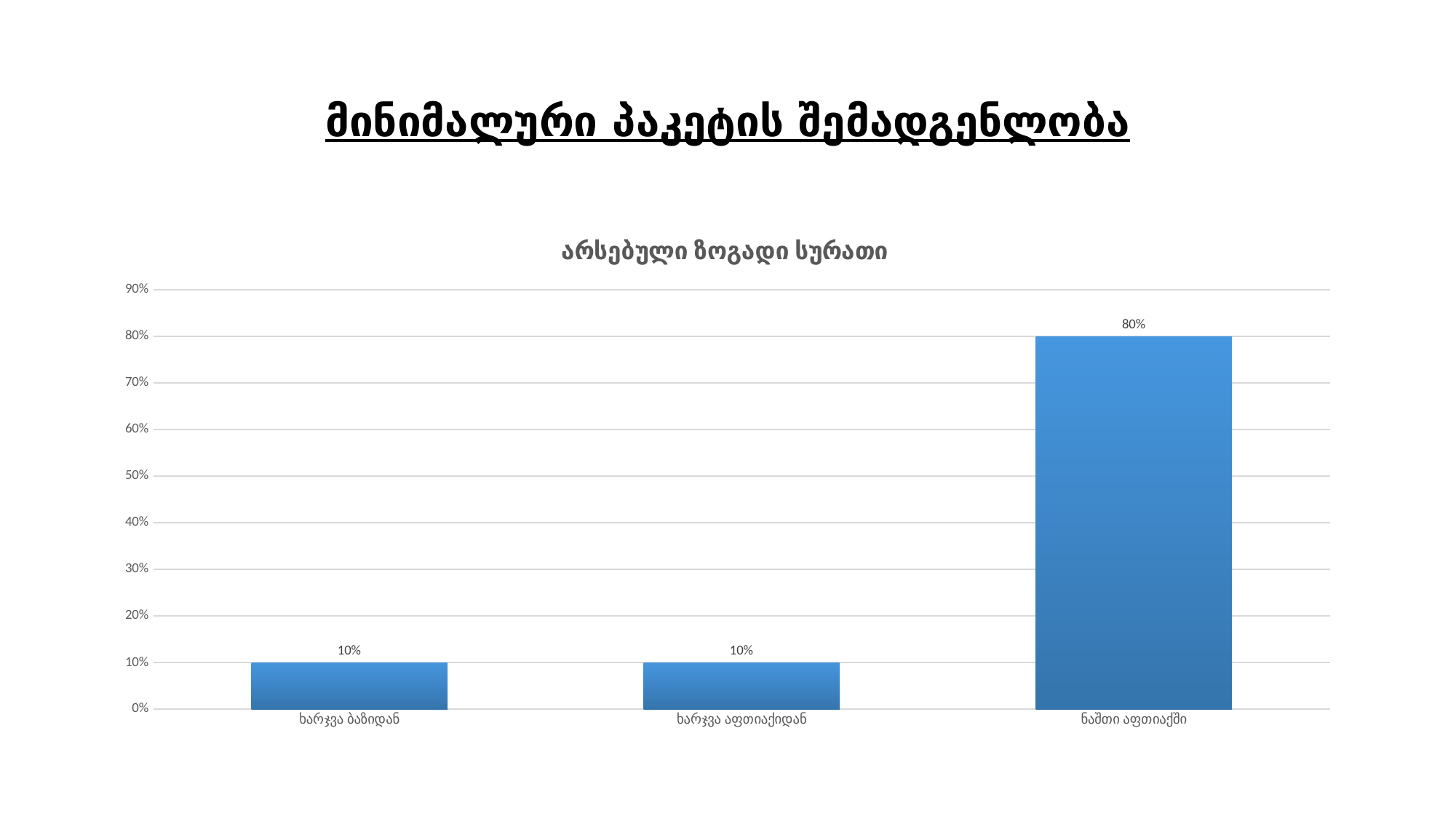
What is the value for ხარჯვა ბაზიდან? 10% What kind of chart is shown on the slide? bar chart What is the value for ხარჯვა აფთიაქიდან? 10% What is the difference between the values for ნაშთი აფთიაქში and ხარჯვა ბაზიდან? 70% What is the highest value shown on the vertical axis? 90% Is the value for ნაშთი აფთიაქში greater or less than 50%? greater How many categories are shown on the chart? 3 Is the value for ხარჯვა ბაზიდან greater or less than 20%? less Which category has the highest value? ნაშთი აფთიაქში What is the title of the chart? არსებული ზოგადი სურათი Which is larger, the value for ნაშთი აფთიაქში or the value for ხარჯვა აფთიაქიდან? ნაშთი აფთიაქში What is the value for ნაშთი აფთიაქში? 80%